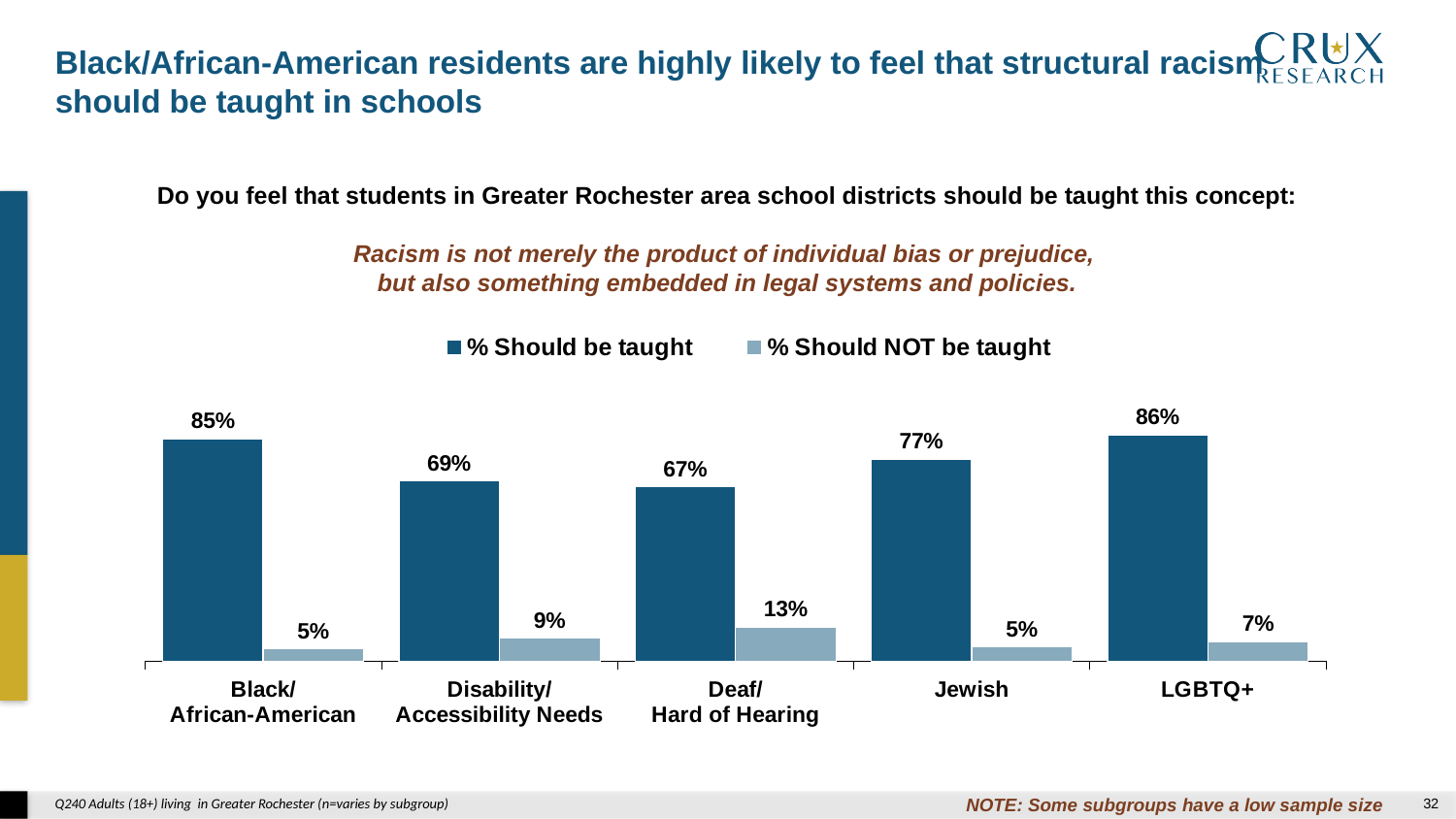
What are the two legend entries of the chart? % Should be taught; % Should NOT be taught How many groups are shown on the x axis of the chart? 5 Which group has the highest '% Should NOT be taught' value? Deaf/Hard of Hearing What percentage of Black/African-American respondents say the concept should be taught? 85% What is the difference between the '% Should be taught' values for LGBTQ+ and Disability/Accessibility Needs respondents? 17 percentage points Which group has the highest '% Should be taught' value? LGBTQ+ What is the '% Should NOT be taught' value for Deaf/Hard of Hearing respondents? 13% What is the '% Should be taught' value for Jewish respondents? 77% What kind of chart is shown on the slide? Bar chart How many series does the legend list? 2 Which group has the lowest '% Should be taught' value? Deaf/Hard of Hearing Which is larger: the '% Should NOT be taught' value for Disability/Accessibility Needs or for LGBTQ+? Disability/Accessibility Needs